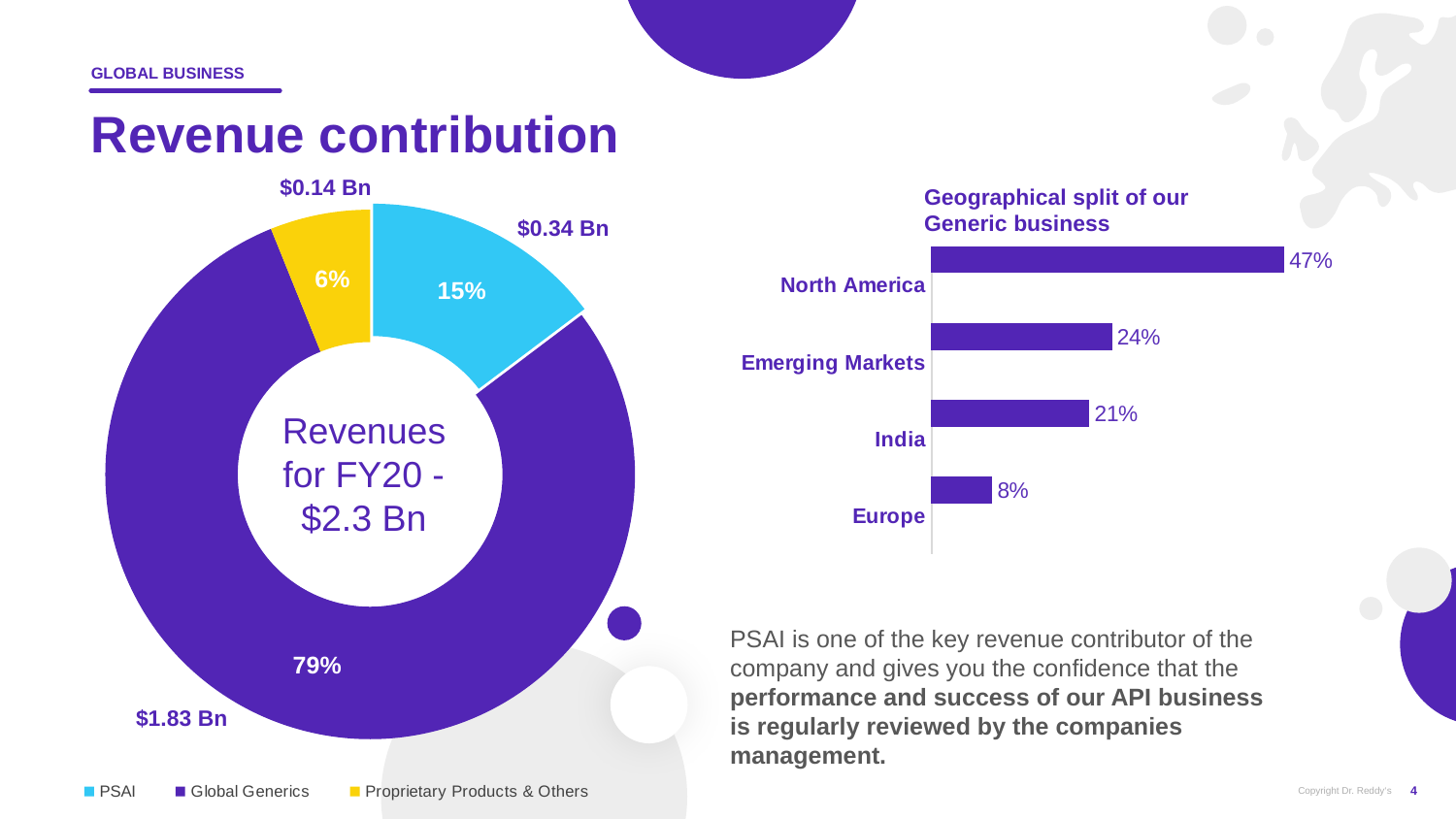
What kind of chart is the 'Geographical split of our Generic business' chart? Bar chart In the 'Geographical split of our Generic business' chart, what is the value for North America? 47% In the 'Geographical split of our Generic business' chart, what is the value for Europe? 8% In the donut chart on the left, what is the revenue value for PSAI? $0.34 Bn In the donut chart on the left, what is the revenue value for Proprietary Products & Others? $0.14 Bn In the 'Geographical split of our Generic business' chart, how many regions are shown? 4 In the donut chart on the left, what percentage share does Global Generics have? 79% How many entries does the legend of the donut chart on the left list? 3 In the 'Geographical split of our Generic business' chart, which region has the highest value? North America In the 'Geographical split of our Generic business' chart, what is the difference between Emerging Markets and India? 3% In the donut chart on the left, which segment is larger: PSAI or Proprietary Products & Others? PSAI In the 'Geographical split of our Generic business' chart, which region has the lowest value? Europe